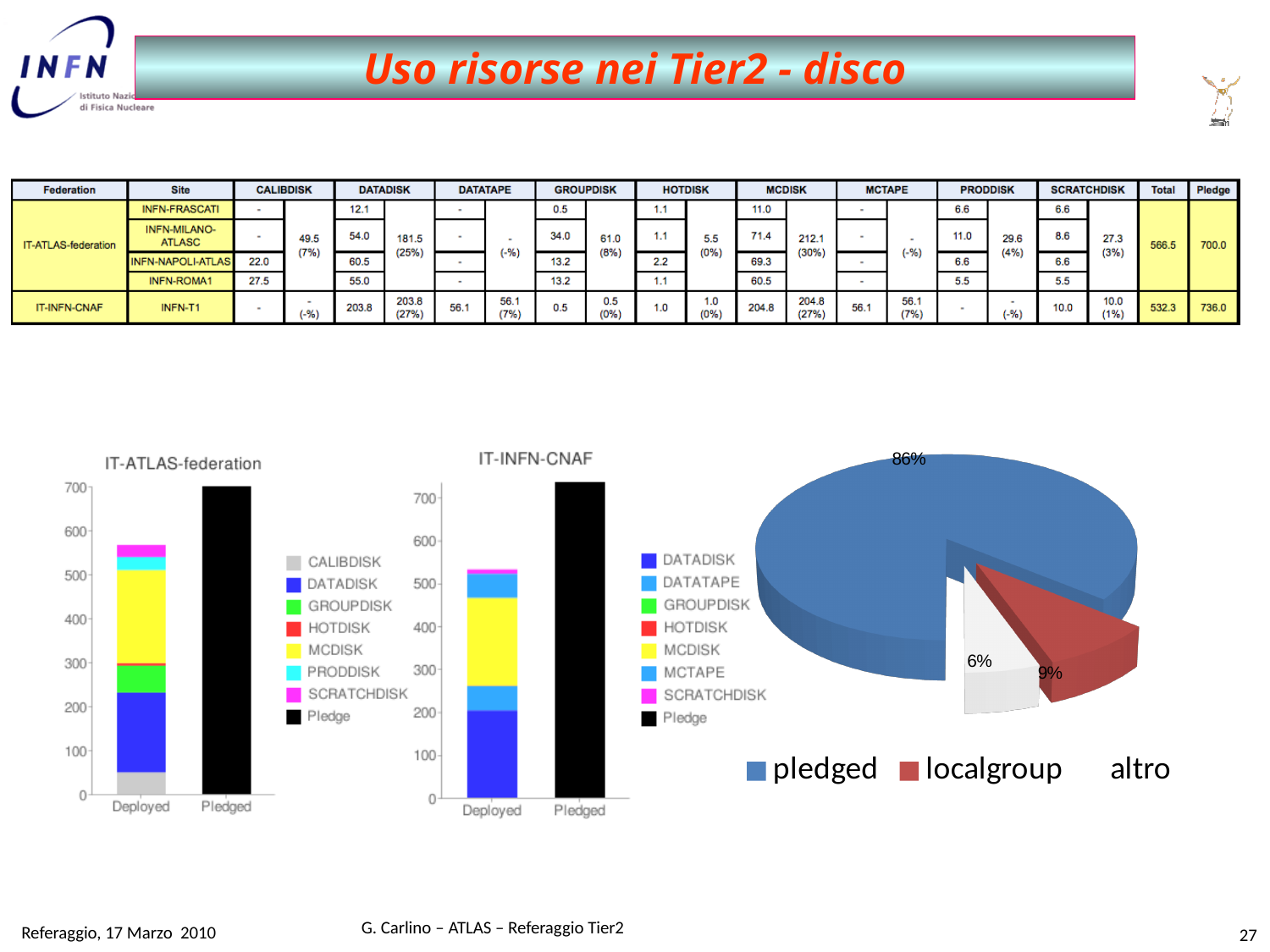
In the pie chart on the right, what share does the localgroup slice have? 9% In the IT-ATLAS-federation chart, is the Deployed bar greater or less than 500? greater In the pie chart on the right, what is the difference between the localgroup share and the altro share? 3% In the pie chart on the right, what share does the altro slice have? 6% In the pie chart on the right, which slice is the smallest? altro What kind of chart is the IT-ATLAS-federation chart on the left? bar chart How many slices does the pie chart on the right have? 3 How many series does the legend of the IT-INFN-CNAF chart list? 8 In the pie chart on the right, which slice is the largest? pledged What kind of chart is the chart on the right with the pledged, localgroup and altro legend? pie chart In the IT-INFN-CNAF chart, is the Pledged bar greater or less than 700? greater In the pie chart on the right, what share does the pledged slice have? 86%